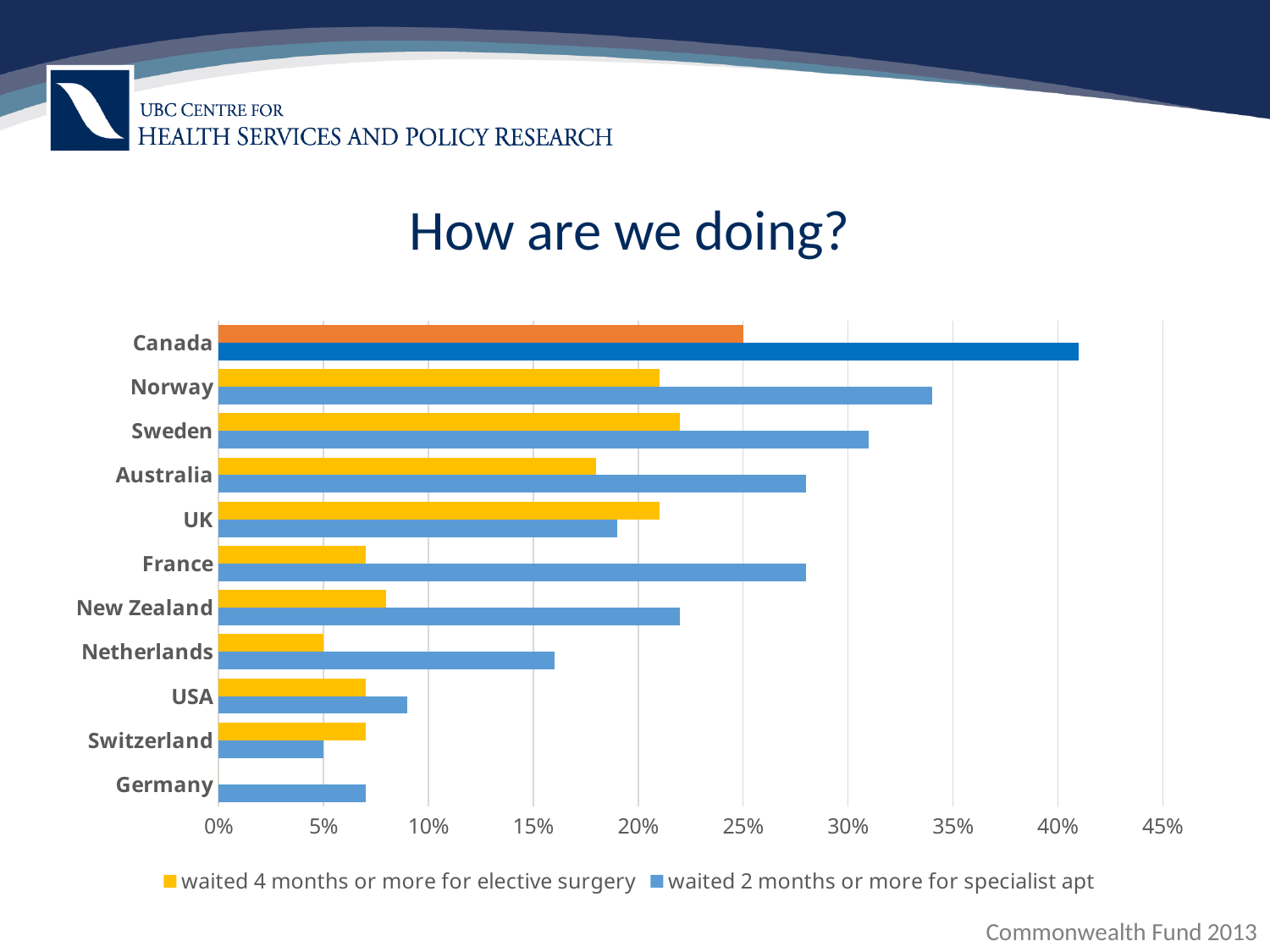
Which country has the highest value for 'waited 2 months or more for specialist apt'? Canada Is the value for France for 'waited 4 months or more for elective surgery' greater or less than 10%? less Is the value for Norway for 'waited 2 months or more for specialist apt' greater or less than 30%? greater How many series does the legend list? 2 What is the value for Canada for 'waited 4 months or more for elective surgery'? 25% What is the source cited at the bottom of the slide? Commonwealth Fund 2013 What kind of chart is shown on the slide? bar chart What is the value for the Netherlands for 'waited 4 months or more for elective surgery'? 5% How many countries are shown on the chart? 11 Which is larger for 'waited 2 months or more for specialist apt': Sweden or Australia? Sweden Is the value for Canada for 'waited 2 months or more for specialist apt' greater or less than 40%? greater Which country has the lowest value for 'waited 2 months or more for specialist apt'? Switzerland